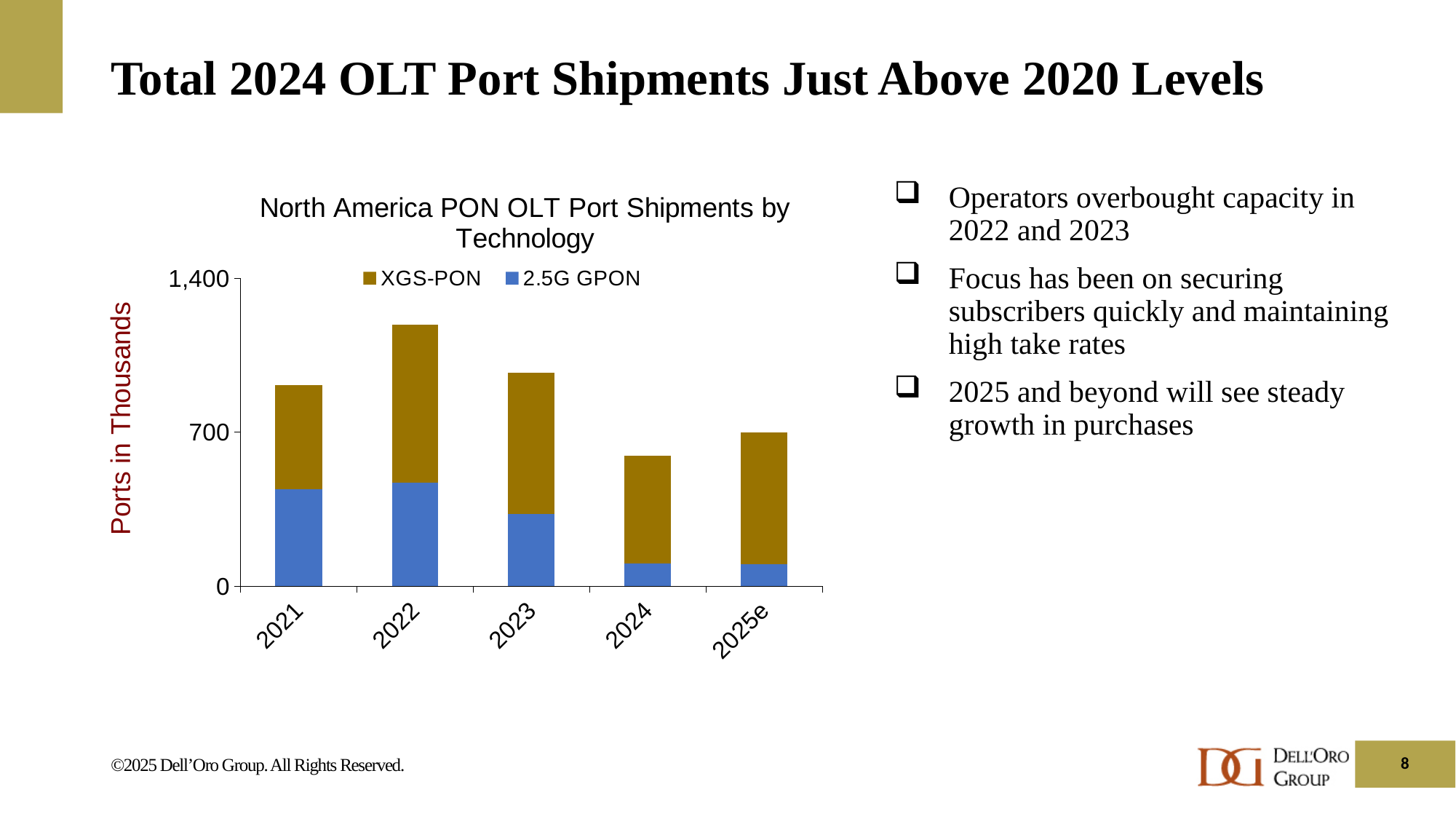
Is the total value for 2022 greater or less than 700? greater Is the total value for 2024 greater or less than 700? less What kind of chart is shown on the slide? Stacked bar chart Which year has the highest total PON OLT port shipments? 2022 How many series does the legend of the chart list? 2 How many years are shown on the x axis of the chart? 5 Is the 2.5G GPON value for 2021 greater or less than 700? less Which year has the lowest total PON OLT port shipments? 2024 In 2024, which series is larger, XGS-PON or 2.5G GPON? XGS-PON Which is larger, the total shipments in 2022 or in 2024? 2022 What is the label on the vertical axis of the chart? Ports in Thousands Do total shipments rise or fall from 2022 to 2024? fall